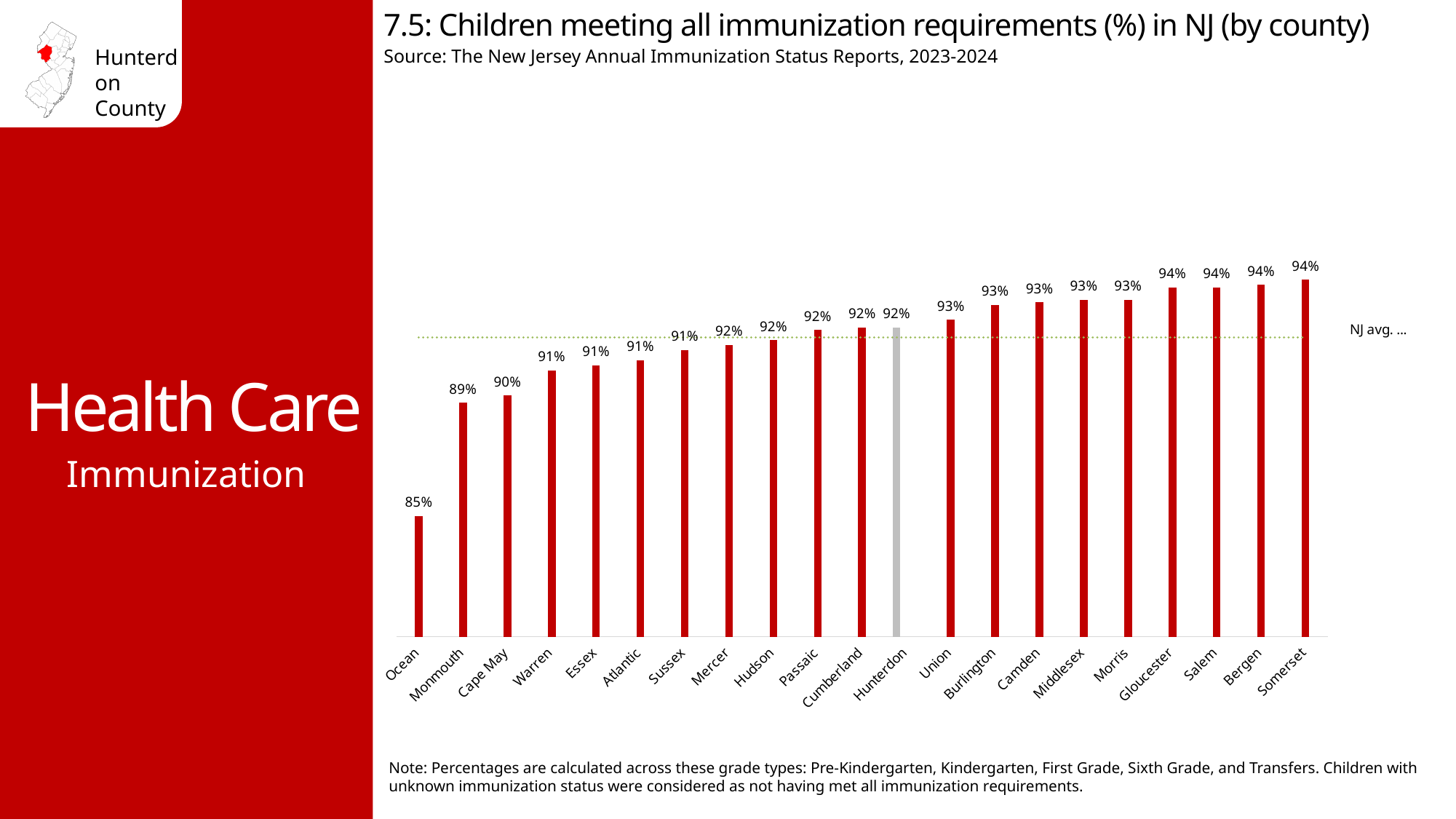
Which has a higher value, Ocean or Monmouth? Monmouth Which county's bar is coloured grey instead of red? Hunterdon Which county has the lowest percentage of children meeting all immunization requirements? Ocean What percentage is shown for Monmouth County? 89% Do the values generally rise or fall from left to right across the counties? Rise What is the difference in percentage points between Somerset and Ocean? 9 What is the value shown for Hunterdon County? 92% What is the value for Somerset County? 94% What percentage of children in Ocean County met all immunization requirements? 85% How many counties are shown in the chart? 21 What kind of chart is shown on the slide? Bar chart What is the value shown for Cape May? 90%